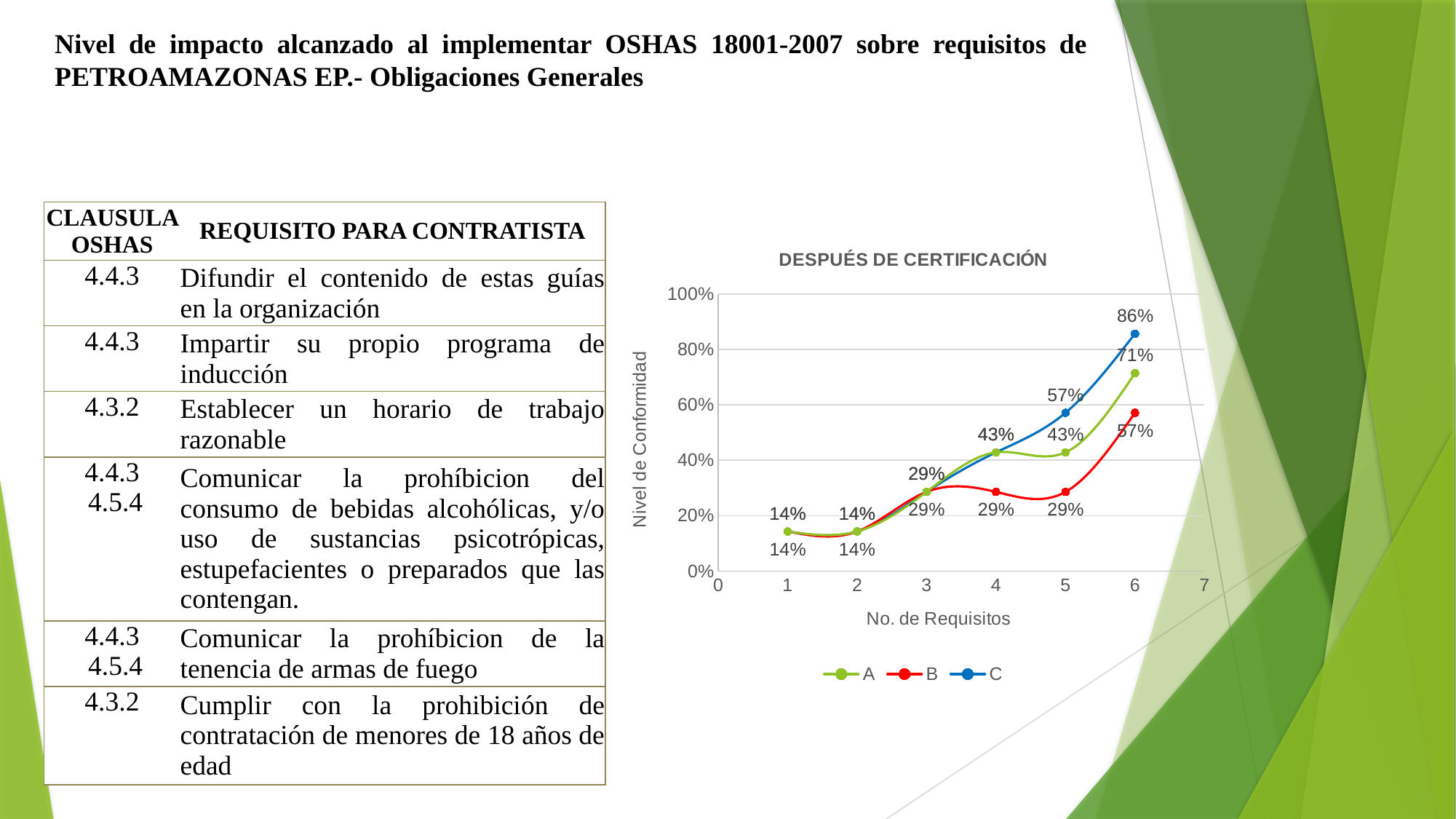
Which series has the highest value at requisito 6? C How many series does the legend of the chart list? 3 What is the value of series B at requisito 5? 29% What is the title of the chart? DESPUÉS DE CERTIFICACIÓN What kind of chart is shown on the slide? line chart What is the value of series C at requisito 6? 86% What is the value of series A at requisito 6? 71% What is the difference between series C and series B at requisito 6? 29% At requisito 5, which series has the larger value, A or B? A Does series C rise or fall as the number of requisitos increases from 1 to 6? rise What is the value of series B at requisito 6? 57% Which series has the lowest value at requisito 6? B